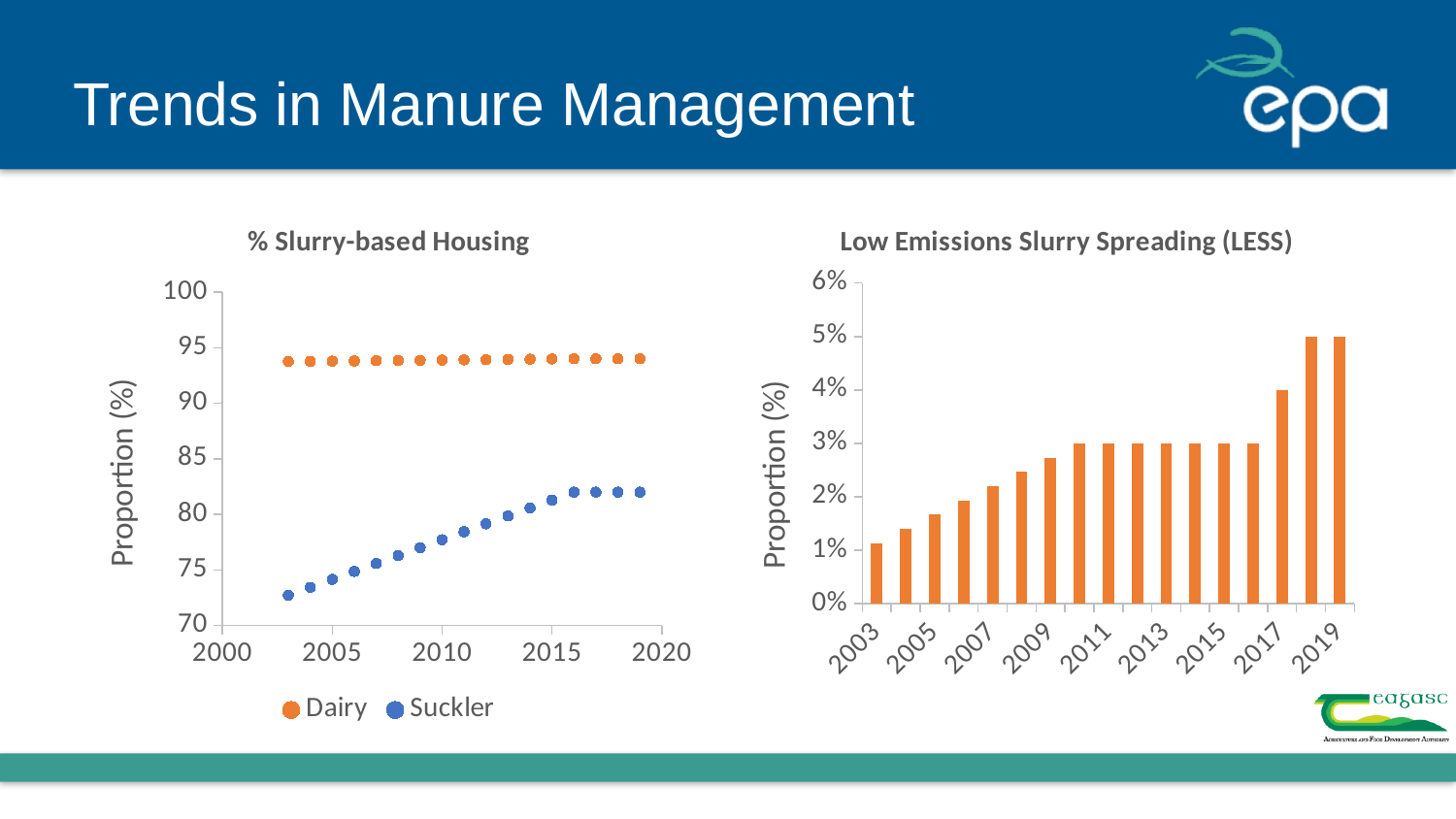
What kind of chart is the 'Low Emissions Slurry Spreading (LESS)' chart on the right? bar chart In the '% Slurry-based Housing' chart, which series has the higher value in 2015, Dairy or Suckler? Dairy In the '% Slurry-based Housing' chart, how many series does the legend list? 2 In the '% Slurry-based Housing' chart, what are the two series named in the legend? Dairy and Suckler In the '% Slurry-based Housing' chart, is the Suckler value for 2003 greater or less than 75? less In the 'Low Emissions Slurry Spreading (LESS)' chart, what is the value for 2019? 5% In the 'Low Emissions Slurry Spreading (LESS)' chart, how many bars are plotted? 17 In the '% Slurry-based Housing' chart, is the Dairy value for 2010 greater or less than 90? greater In the 'Low Emissions Slurry Spreading (LESS)' chart, what is the value for 2017? 4% In the '% Slurry-based Housing' chart, does the Suckler series rise or fall from 2003 to 2019? rise What kind of chart is the '% Slurry-based Housing' chart on the left? scatter chart In the 'Low Emissions Slurry Spreading (LESS)' chart, which year has the lowest value? 2003